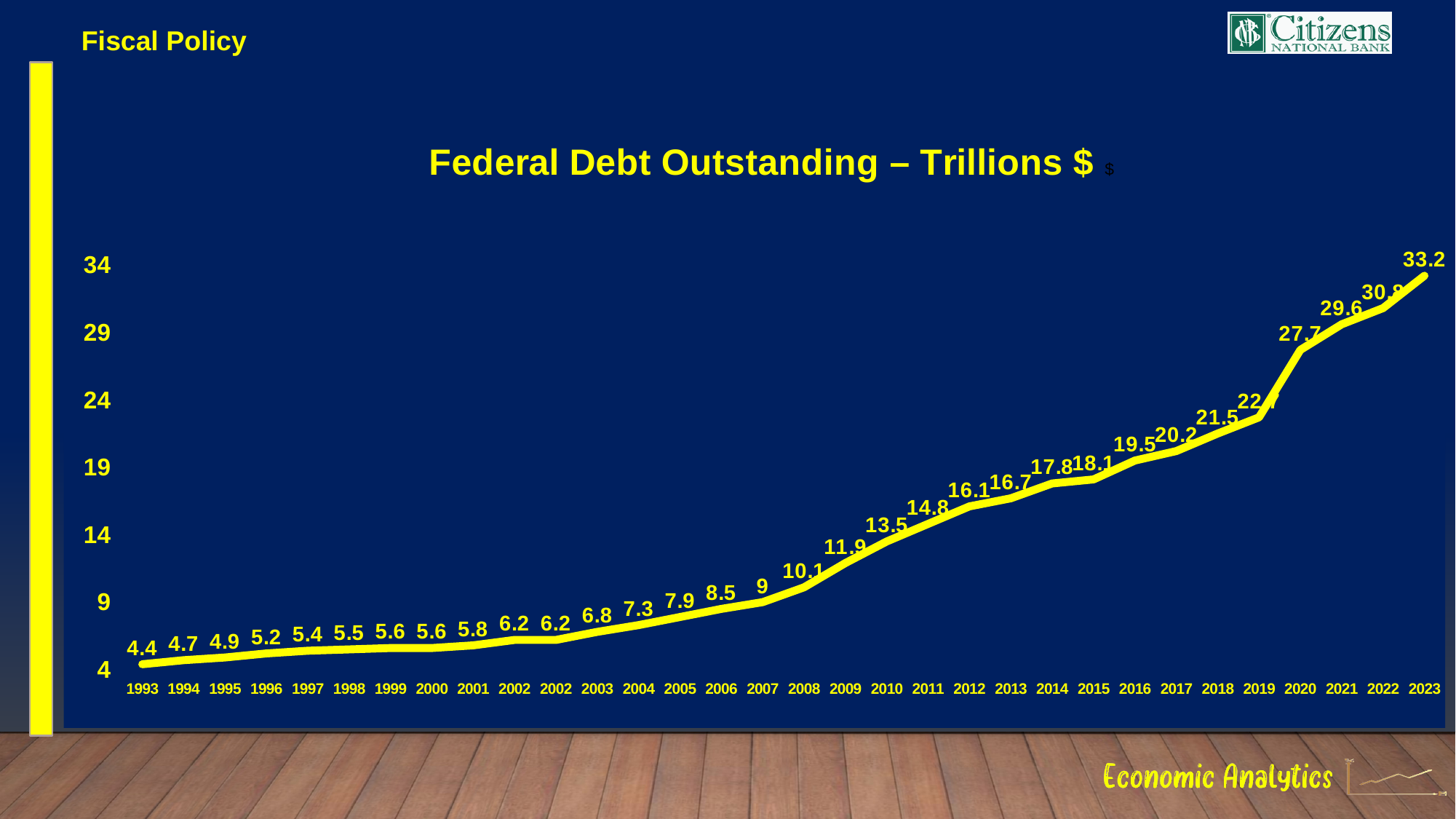
What is the federal debt outstanding value for 2016? 19.5 What kind of chart is shown on the slide? line chart What is the federal debt outstanding value for 2020? 27.7 What is the difference between the federal debt outstanding in 2023 and in 1993? 28.8 Which year has a larger federal debt outstanding, 2005 or 2010? 2010 What is the federal debt outstanding value for 1993? 4.4 What is the difference between the federal debt outstanding in 2020 and in 2018? 6.2 Do the values rise or fall from 1993 to 2023? rise Which year has the lowest federal debt outstanding? 1993 What is the federal debt outstanding value for 2008? 10.1 What is the federal debt outstanding value for 2023? 33.2 Which year has the highest federal debt outstanding? 2023